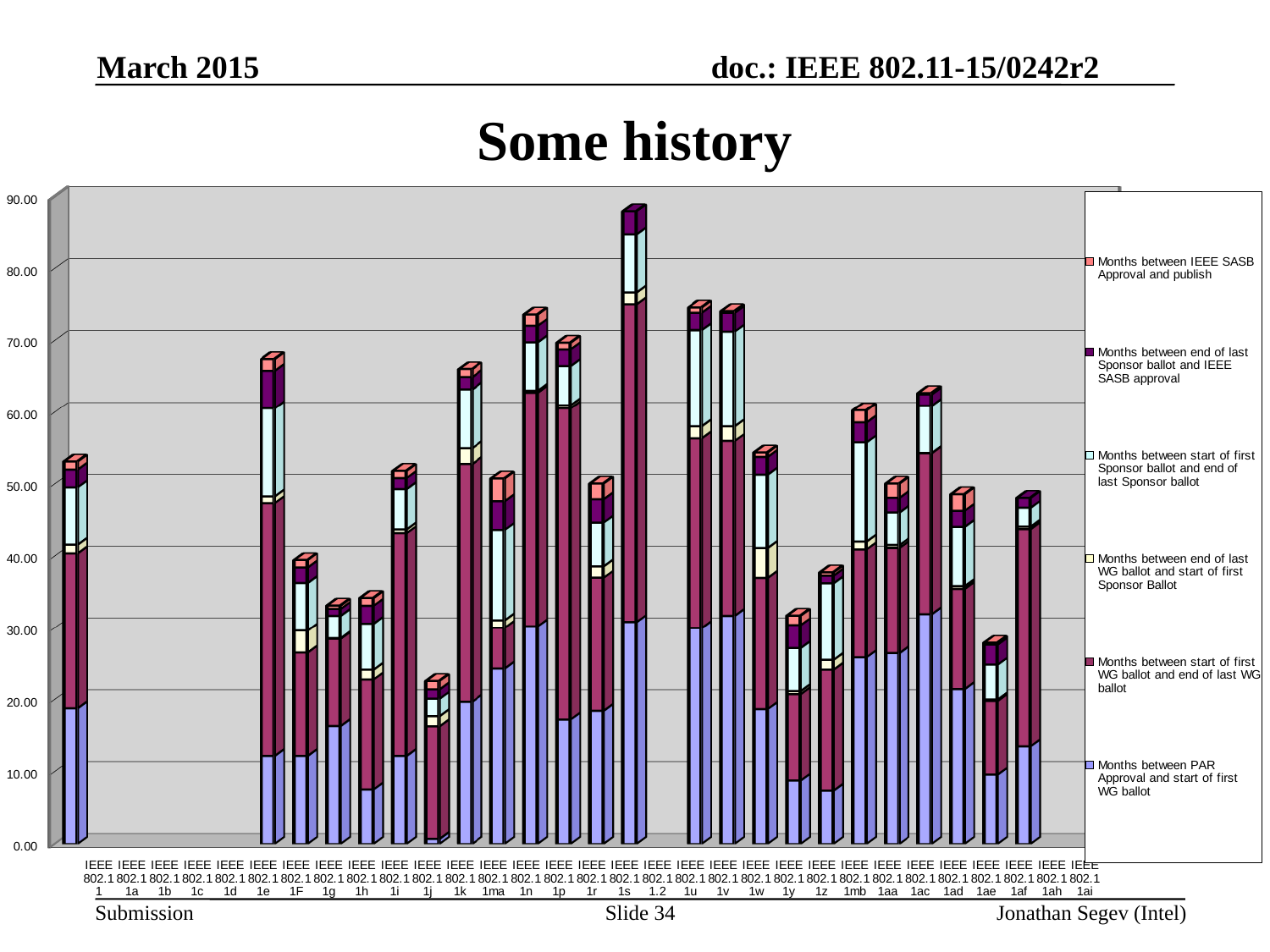
Which has the taller stacked bar, IEEE 802.11s or IEEE 802.11u? IEEE 802.11s Which category has the tallest stacked bar? IEEE 802.11s Is the total stacked value for IEEE 802.11g greater or less than 40? less Is the total stacked value for IEEE 802.11e greater or less than 60? greater What is the title of the chart? Some history Is the total stacked value for IEEE 802.11s greater or less than 80? greater Which has the taller stacked bar, IEEE 802.11e or IEEE 802.11g? IEEE 802.11e Which category with a plotted bar has the shortest stacked bar? IEEE 802.11j How many series does the legend list? 6 What kind of chart is shown on the slide? Stacked bar chart